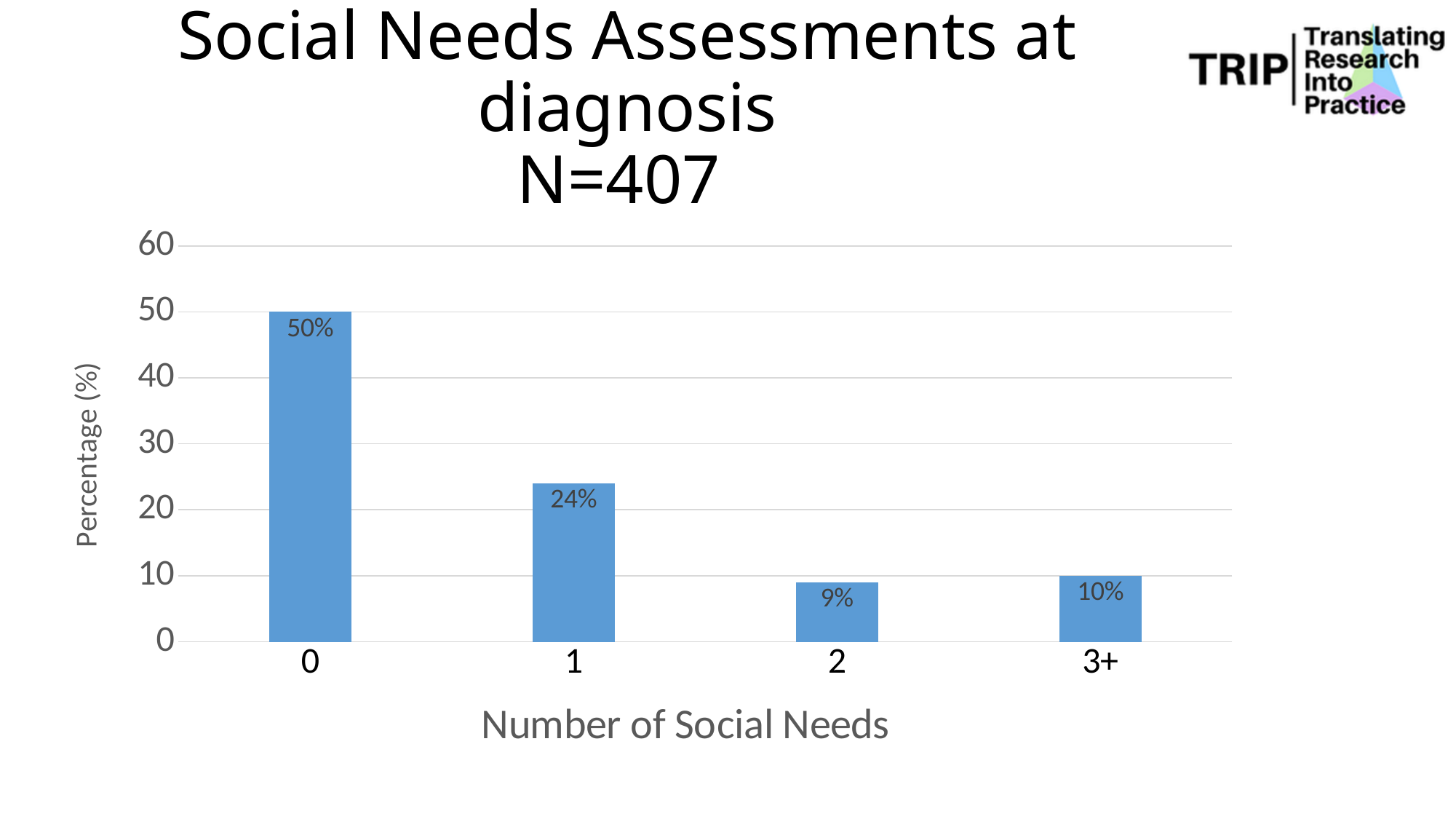
Which category has a larger percentage, 1 social need or 3+ social needs? 1 Which number of social needs category has the highest percentage? 0 Which number of social needs category has the lowest percentage? 2 What kind of chart is shown on the slide? Bar chart Is the value for 1 social need greater or less than 20? greater What is the label of the x axis? Number of Social Needs What percentage of patients had 2 social needs? 9% What is the difference in percentage between the 0 and 1 social needs categories? 26% What percentage of patients had 1 social need? 24% What percentage of patients had 0 social needs? 50% How many categories are shown on the x axis? 4 What percentage of patients had 3+ social needs? 10%